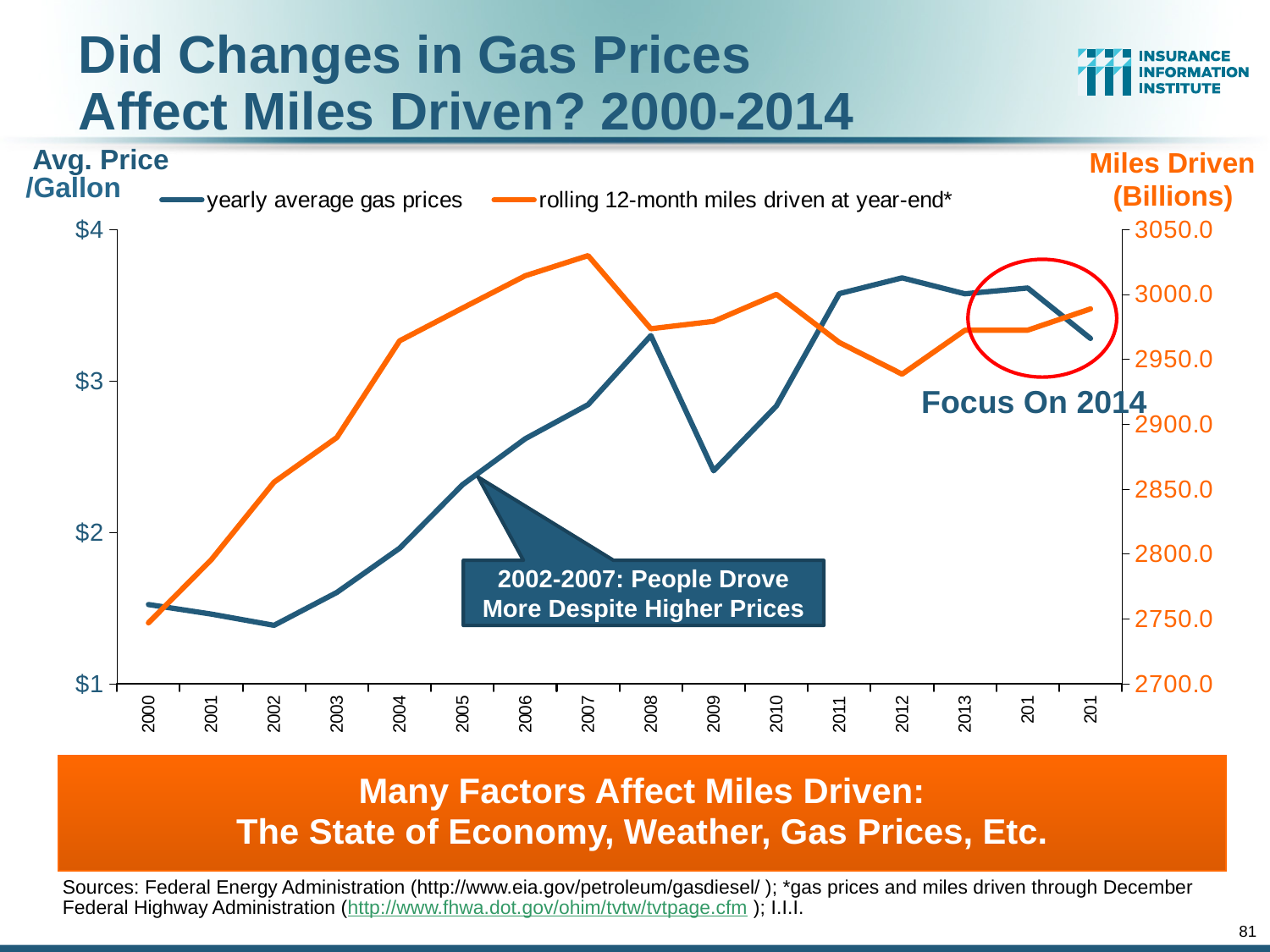
Which year has the higher yearly average gas price, 2008 or 2009? 2008 In which year is the rolling 12-month miles driven series at its lowest? 2000 In which year is the rolling 12-month miles driven series at its highest? 2007 What is the label on the right-hand vertical axis? Miles Driven (Billions) What kind of chart is shown on the slide? line chart Do yearly average gas prices rise or fall from 2002 to 2008? rise Which series is drawn in orange? rolling 12-month miles driven at year-end* Is the yearly average gas price for 2002 greater or less than $2? less Is the yearly average gas price for 2012 greater or less than $3? greater Is the rolling 12-month miles driven value for 2000 greater or less than 2800.0? less How many series does the legend list? 2